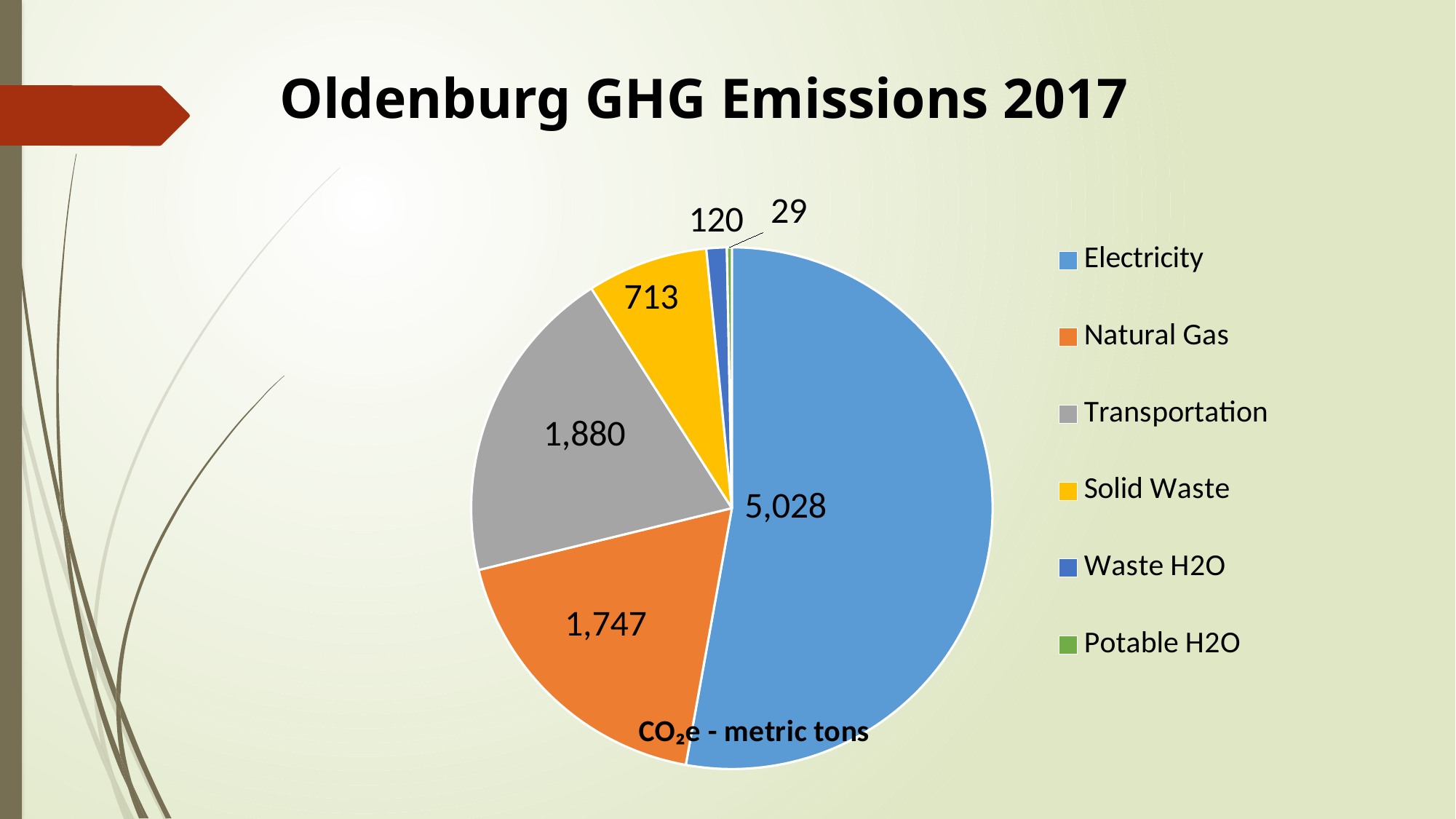
How many categories are shown in the pie chart? 6 What is the value for Electricity in the pie chart? 5,028 What is the value for Potable H2O in the pie chart? 29 Which is larger, the value for Natural Gas or the value for Transportation? Transportation What is the title of the chart on the slide? CO₂e - metric tons What is the value for Transportation in the pie chart? 1,880 What is the difference between the Transportation and Natural Gas values? 133 Which category has the largest slice of the pie chart? Electricity Which category has the smallest slice of the pie chart? Potable H2O What is the value for Solid Waste in the pie chart? 713 What is the total of all the values shown in the pie chart? 9,517 What kind of chart is shown on the slide? Pie chart